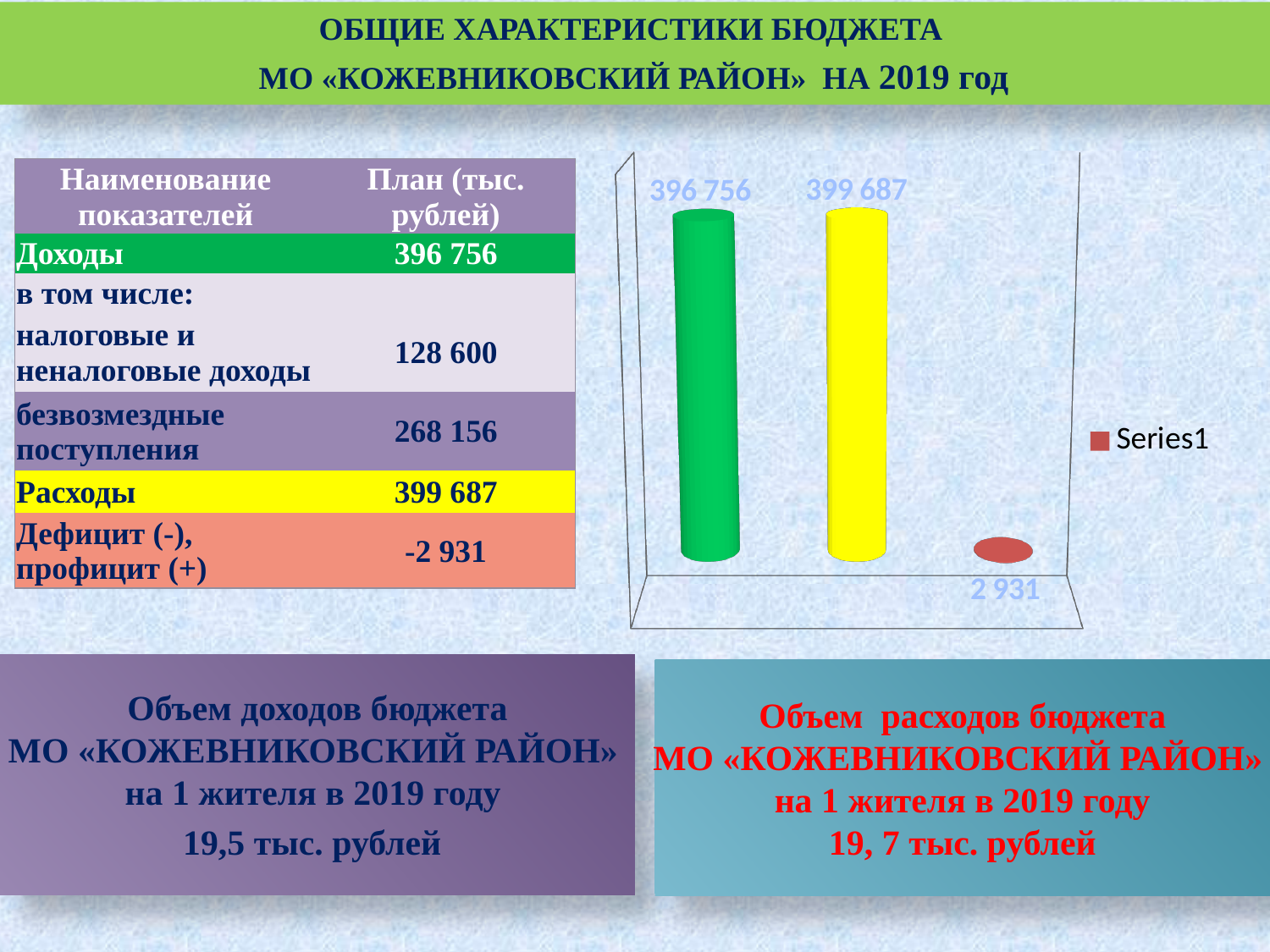
What is the data label on the red (third) bar in the chart? 2 931 What kind of chart is shown on the right side of the slide? bar chart Which bar in the chart has the lowest value? the red (third) bar, 2 931 What is the data label on the yellow (second) bar in the chart? 399 687 How many bars are plotted in the chart? 3 What is the data label on the green (first) bar in the chart? 396 756 Which is larger in the chart: the green bar's value or the red bar's value? the green bar's value How many series does the chart legend list? 1 What colour is the bar with the value 399 687? yellow What is the difference between the yellow bar's value (399 687) and the green bar's value (396 756)? 2 931 Which bar in the chart has the highest value? the yellow (second) bar, 399 687 What is the name of the series shown in the chart legend? Series1